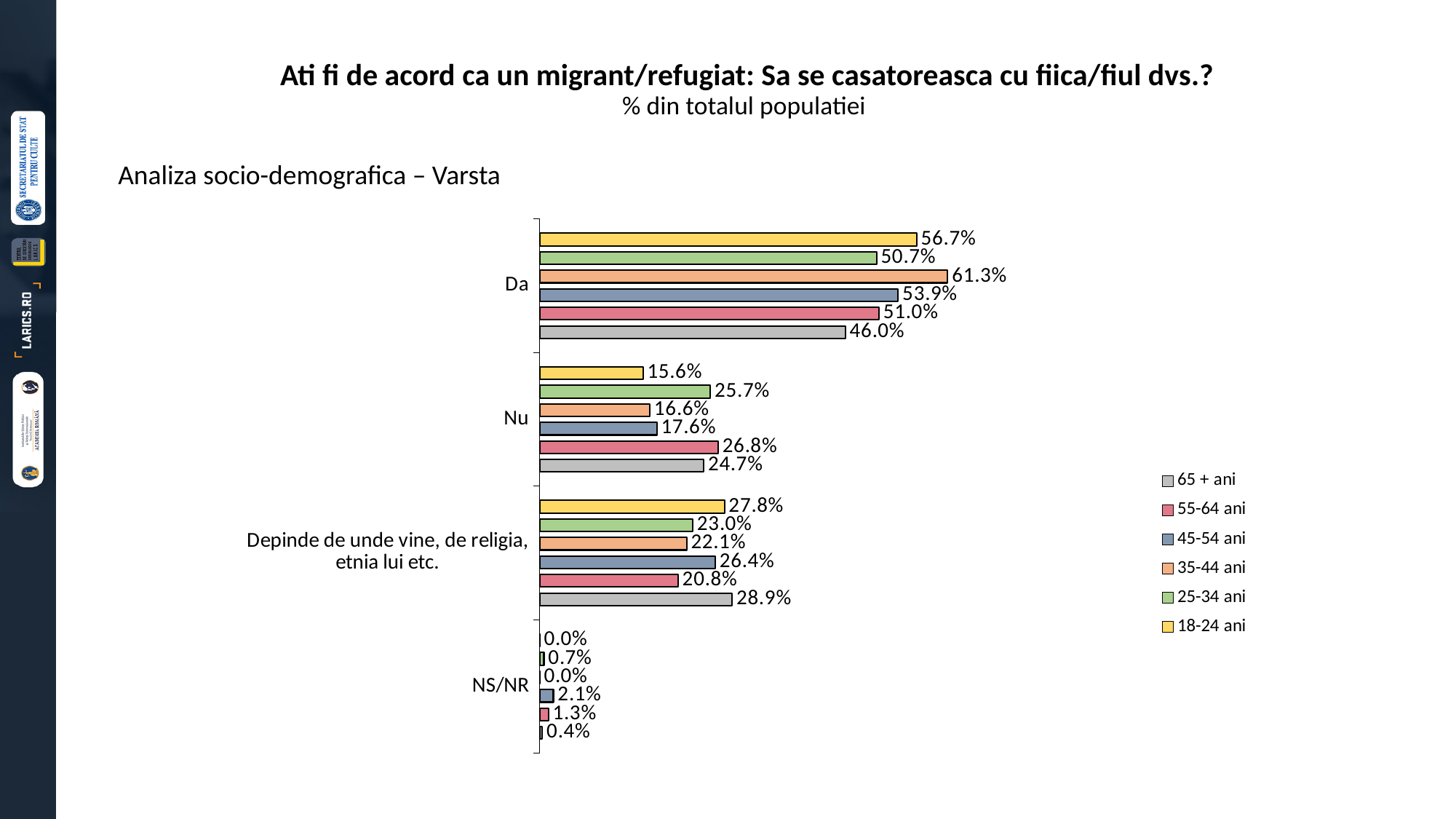
What is the value for the 65 + ani series in the Nu category? 24.7% What is the value for the 45-54 ani series in the NS/NR category? 2.1% How many response categories are shown on the chart? 4 What is the value for the 35-44 ani series in the Da category? 61.3% In the Nu category, which is larger: the value for 25-34 ani or the value for 35-44 ani? 25-34 ani How many series does the legend list? 6 Which age group has the highest value in the Da category? 35-44 ani Which age group has the lowest value in the Da category? 65 + ani What kind of chart is shown on the slide? Bar chart What is the value for the 18-24 ani series in the 'Depinde de unde vine, de religia, etnia lui etc.' category? 27.8% What is the difference between the 18-24 ani and 65 + ani values in the Da category? 10.7% Which age group has the highest value in the Nu category? 55-64 ani